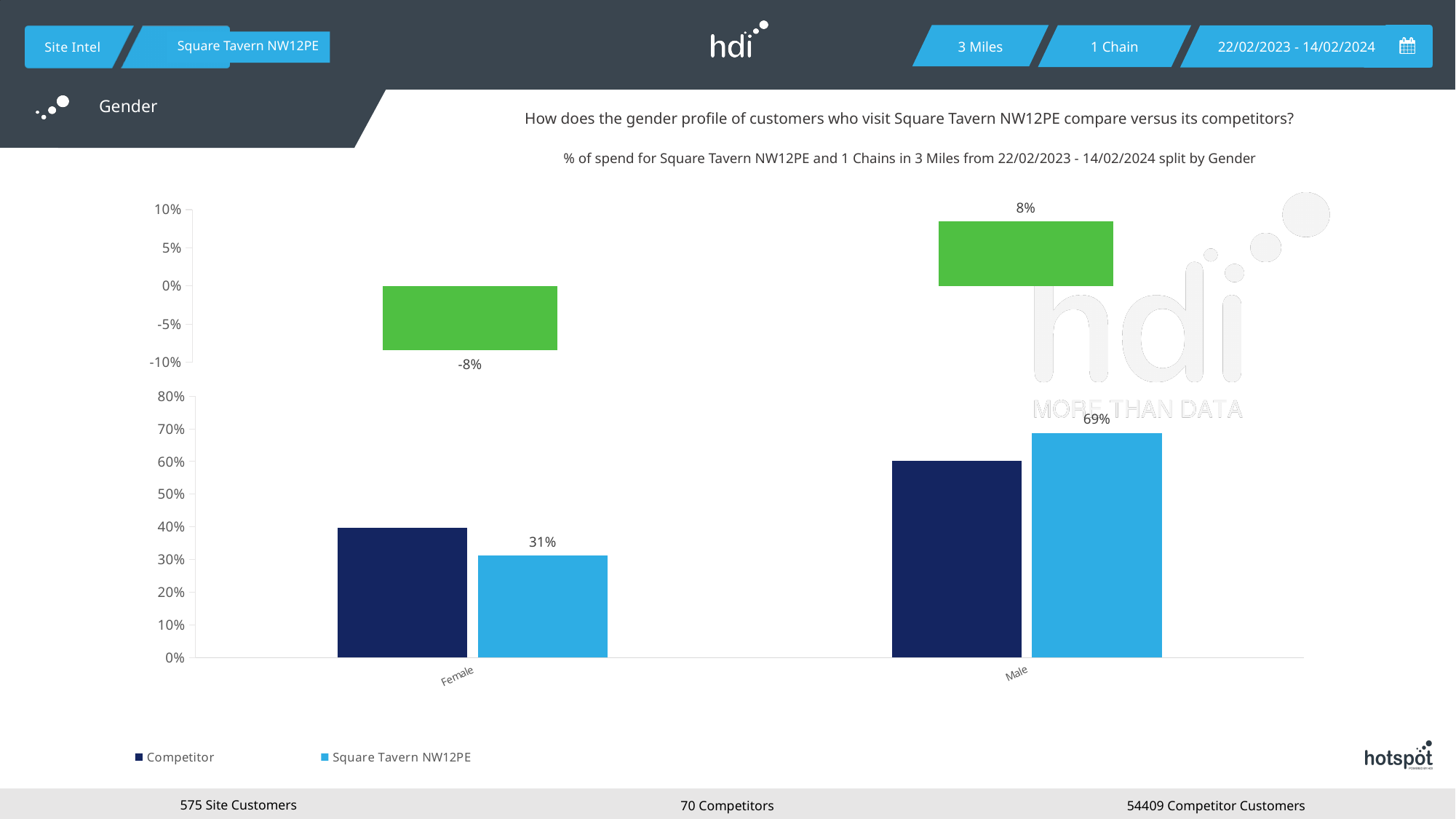
In the lower chart, is the Competitor value for Female greater or less than 50%? less In the lower chart, which is larger for Female: Competitor or Square Tavern NW12PE? Competitor In the lower chart, what is the value for Square Tavern NW12PE for Female? 31% In the upper chart, what is the value shown for Female? -8% In the lower chart, which is larger for Male: Competitor or Square Tavern NW12PE? Square Tavern NW12PE How many categories are shown on the x axis of the lower chart? 2 In the lower chart, what is the value for Square Tavern NW12PE for Male? 69% How many series does the legend of the lower chart list? 2 What type of chart is the lower chart? Bar chart In the lower chart, is the Competitor value for Male greater or less than 50%? greater In the upper chart, what is the value shown for Male? 8% In the lower chart, what is the difference between the Square Tavern NW12PE values for Male and Female? 38%